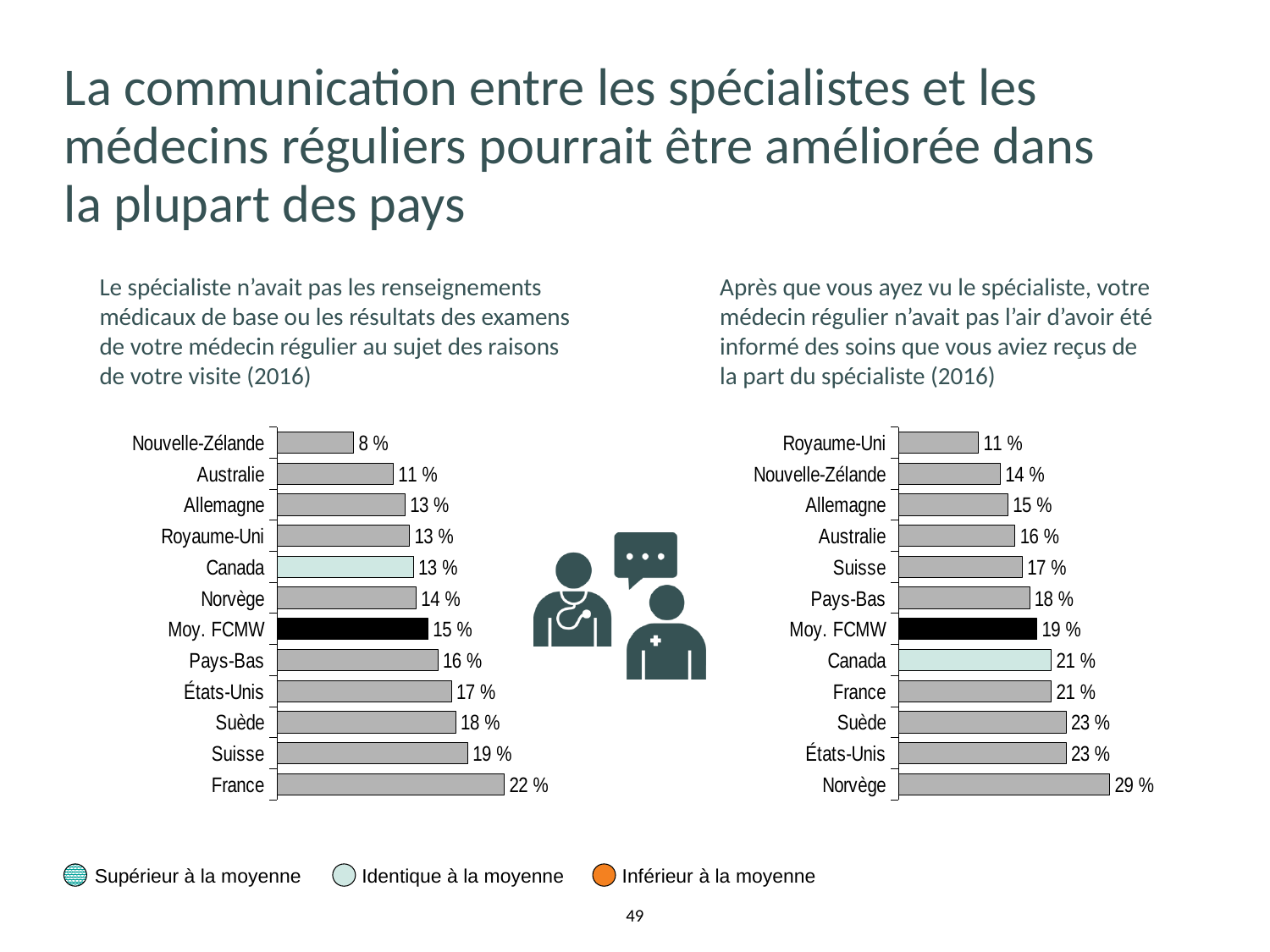
What type of chart is the right chart? Bar chart On the left chart, what is the value for Canada? 13 % On the left chart, which category has the highest value? France On the left chart, how many bars are shown? 12 On the right chart, what is the value for Norvège? 29 % On the right chart, what is the value for Moy. FCMW? 19 % On the left chart, which bar is drawn in black? Moy. FCMW On the left chart, what is the difference between France and Nouvelle-Zélande? 14 % On the right chart, which is larger, the value for Canada or the value for Suisse? Canada On the right chart, which category has the lowest value? Royaume-Uni On the left chart, which category has the lowest value? Nouvelle-Zélande On the right chart, what is the difference between Norvège and Moy. FCMW? 10 %